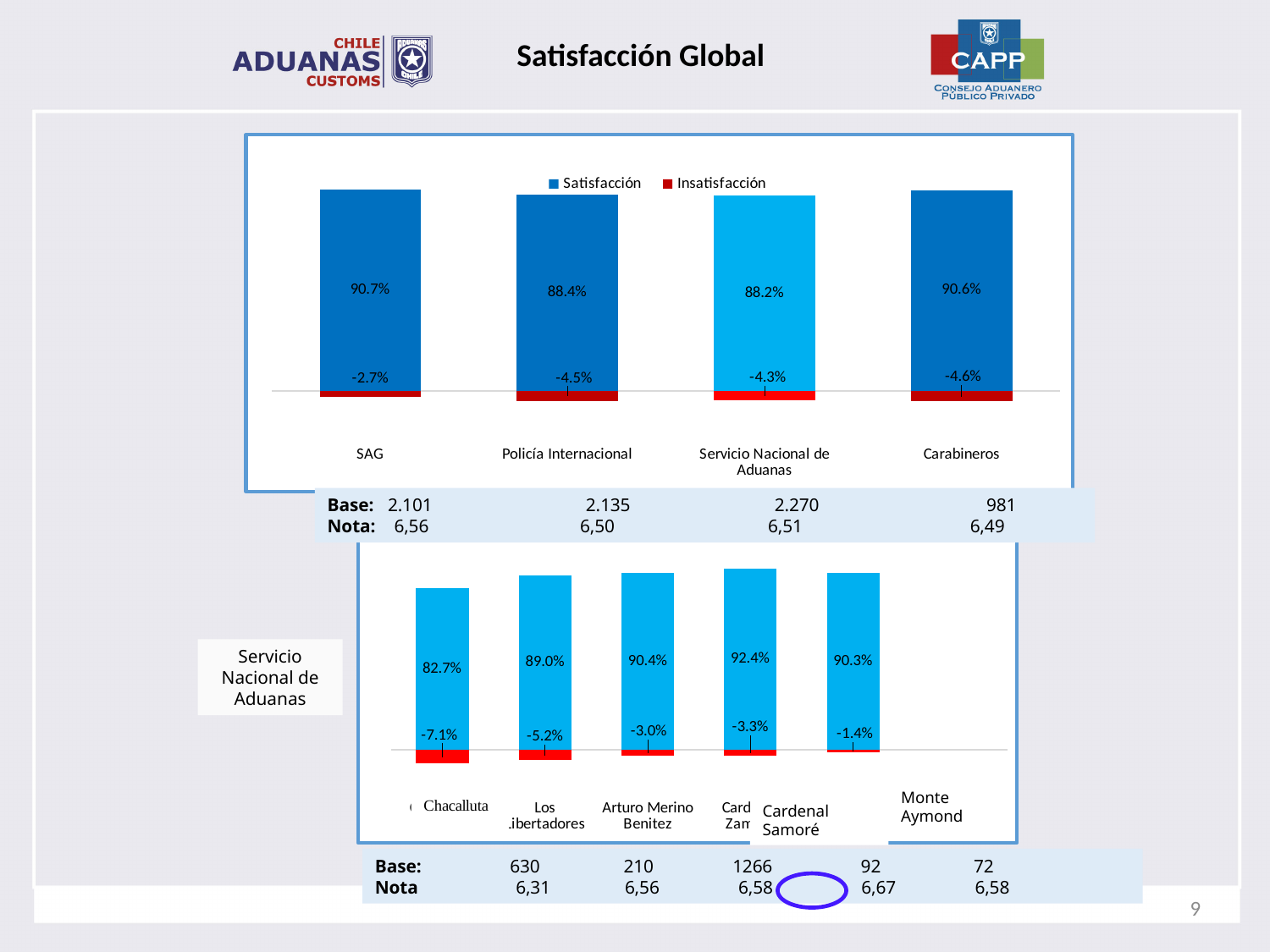
In the bottom chart, which location has the lowest Satisfacción value? Chacalluta In the top chart, which category has the lowest Satisfacción value? Servicio Nacional de Aduanas In the top chart, what is the difference between the Satisfacción values for SAG and Policía Internacional? 2.3% In the bottom chart, how many locations are shown? 5 In the top chart, what is the Satisfacción value for SAG? 90.7% In the bottom chart, what is the Satisfacción value for Chacalluta? 82.7% In the top chart, what is the Insatisfacción value for Policía Internacional? -4.5% What type of chart is the top chart? Bar chart In the bottom chart, what is the Insatisfacción value for Monte Aymond? -1.4% In the top chart, which category has the highest Satisfacción value? SAG In the top chart, how many series does the legend list? 2 In the bottom chart, which location has the highest Satisfacción value? Cardenal Samoré